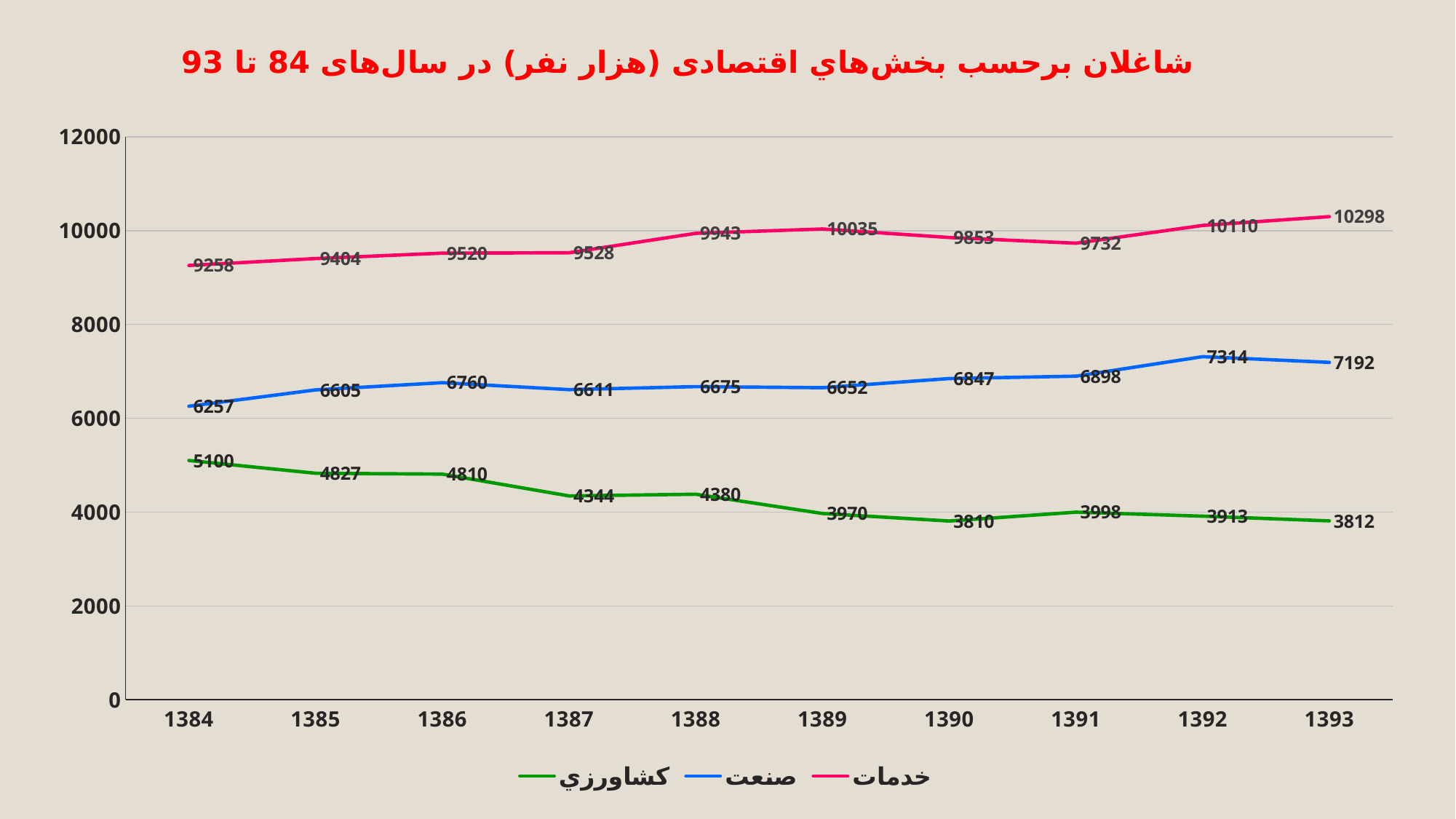
In which year is the value for کشاورزي lowest? 1390 What is the difference between the صنعت values in 1392 and 1393? 122 Which colour is used for the خدمات line? pink How many series does the legend list? 3 What type of chart is shown on the slide? line chart Which is larger, the value for صنعت in 1384 or the value for کشاورزي in 1384? صنعت in 1384 Does the value for کشاورزي generally rise or fall from 1384 to 1393? fall What is the value for کشاورزي in 1390? 3810 In which year is the value for خدمات highest? 1393 How many years are plotted along the x axis? 10 What is the value for خدمات in 1393? 10298 What is the value for صنعت in 1386? 6760